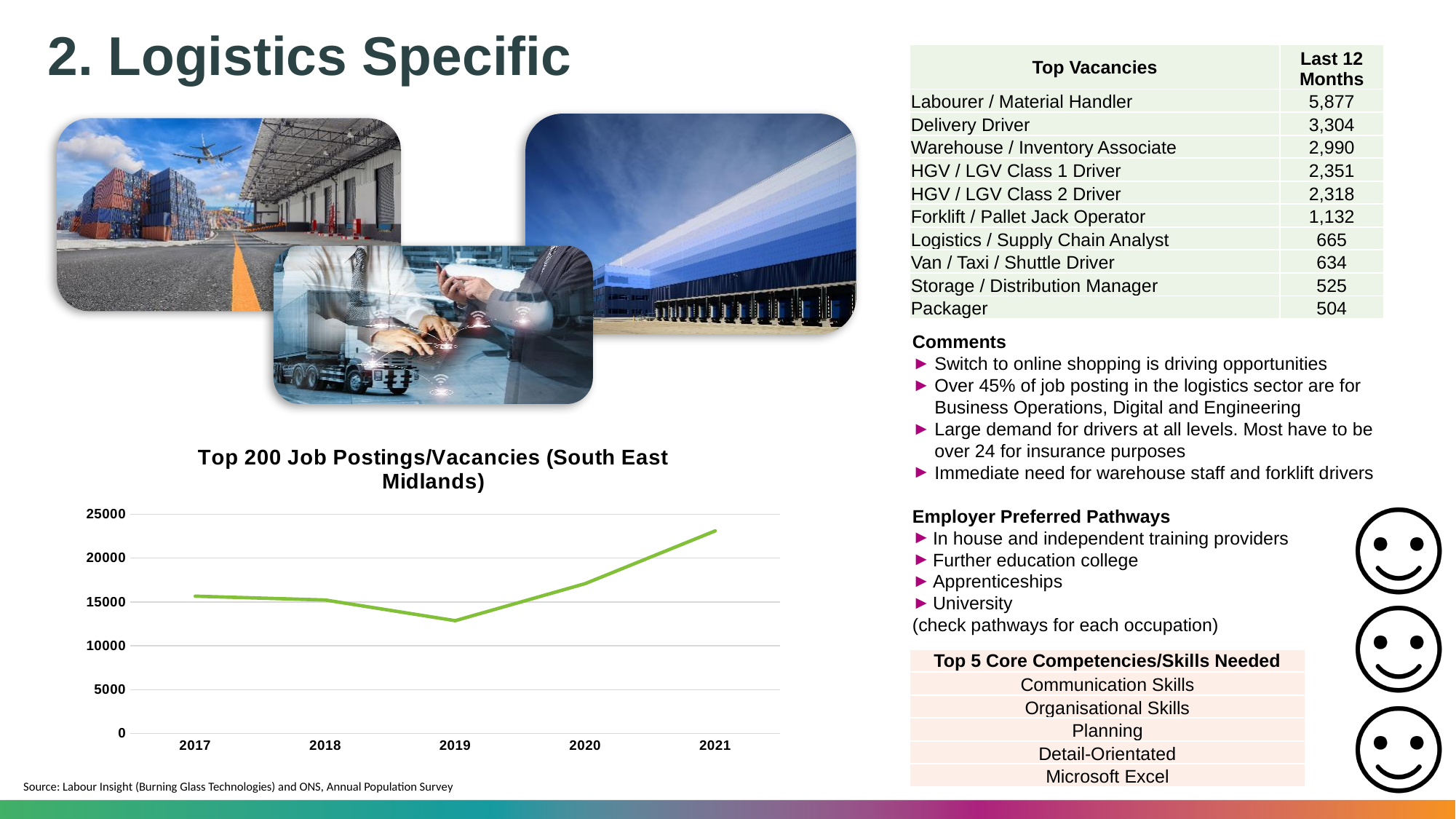
Which year has the highest value in the line chart? 2021 Which year has the lowest value in the line chart? 2019 How many years are plotted on the x axis of the line chart? 5 What kind of chart is shown under the title "Top 200 Job Postings/Vacancies (South East Midlands)"? line chart What is the highest value shown on the y axis of the line chart? 25000 Is the value for 2017 greater or less than 15000? greater Which year has the larger value, 2019 or 2020? 2020 Is the value for 2020 greater or less than 20000? less Is the value for 2021 greater or less than 20000? greater What is the title of the line chart? Top 200 Job Postings/Vacancies (South East Midlands) Do the values in the line chart rise or fall between 2019 and 2021? rise